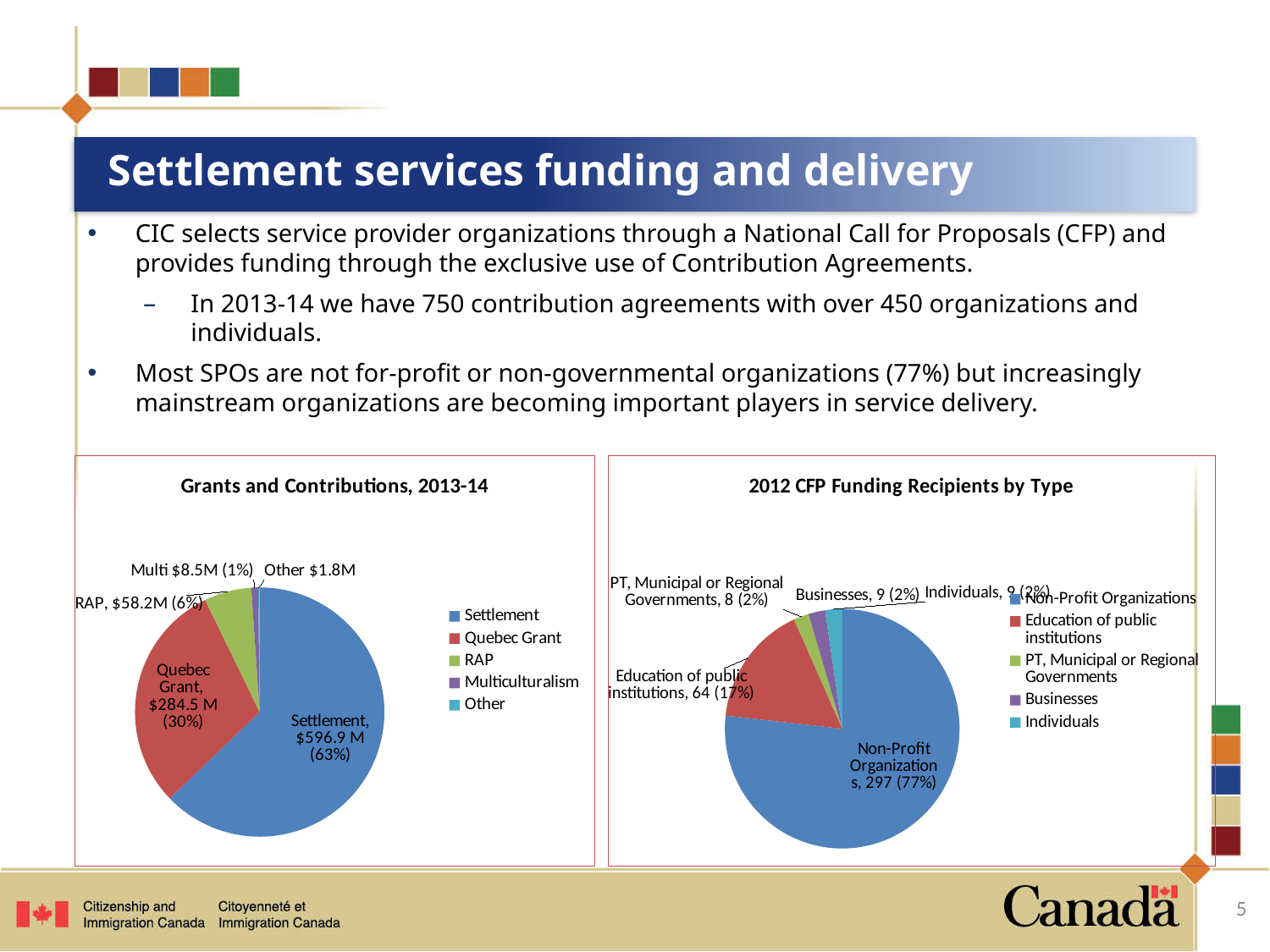
In the 'Grants and Contributions, 2013-14' chart, what share of the pie does RAP represent? 6% In the '2012 CFP Funding Recipients by Type' chart, what share of the pie is Education of public institutions? 17% In the 'Grants and Contributions, 2013-14' chart, what is the value for Quebec Grant? $284.5 M In the 'Grants and Contributions, 2013-14' chart, what is the value for Settlement? $596.9 M In the '2012 CFP Funding Recipients by Type' chart, what is the difference between the number of Non-Profit Organizations and Education of public institutions recipients? 233 In the 'Grants and Contributions, 2013-14' chart, which category has the largest slice? Settlement In the '2012 CFP Funding Recipients by Type' chart, which is larger: Businesses or PT, Municipal or Regional Governments? Businesses What kind of chart is 'Grants and Contributions, 2013-14'? Pie chart In the 'Grants and Contributions, 2013-14' chart, which category has the smallest slice? Other In the '2012 CFP Funding Recipients by Type' chart, how many recipients are Non-Profit Organizations? 297 In the 'Grants and Contributions, 2013-14' chart, how many categories does the legend list? 5 In the '2012 CFP Funding Recipients by Type' chart, what colour is the Non-Profit Organizations slice? Blue